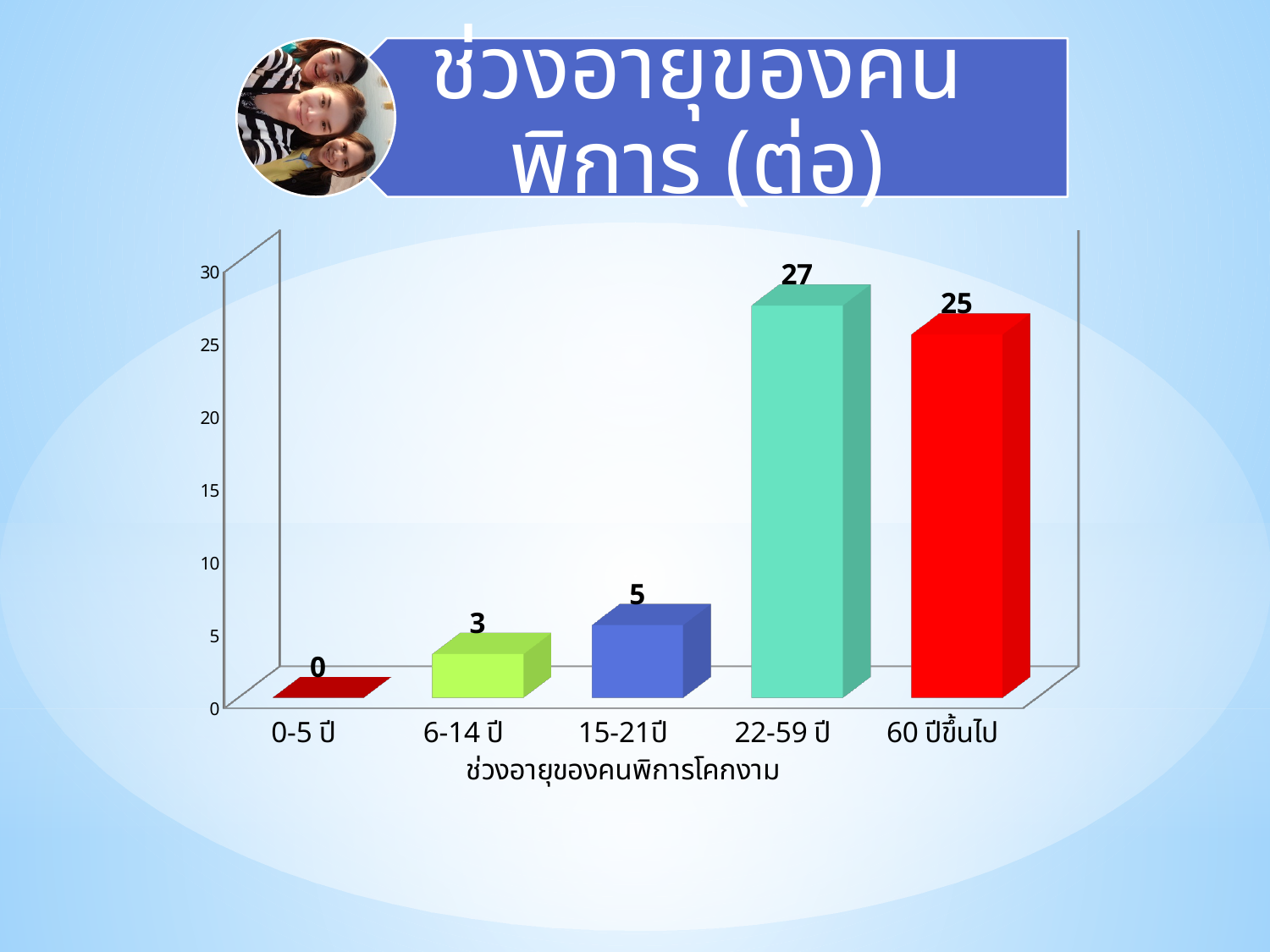
How many age categories are shown on the x axis? 5 Which age category has the lowest value? 0-5 ปี What is the value for the 6-14 ปี category? 3 What is the x-axis title of the chart? ช่วงอายุของคนพิการโคกงาม What kind of chart is shown on the slide? bar chart Which age category has the highest value? 22-59 ปี What is the value for the 22-59 ปี category? 27 What is the difference between the values for 22-59 ปี and 60 ปีขึ้นไป? 2 Which is larger, the value for 15-21ปี or the value for 6-14 ปี? 15-21ปี What is the difference between the values for 15-21ปี and 6-14 ปี? 2 Is the value for 60 ปีขึ้นไป greater or less than 20? greater What is the value for the 60 ปีขึ้นไป category? 25